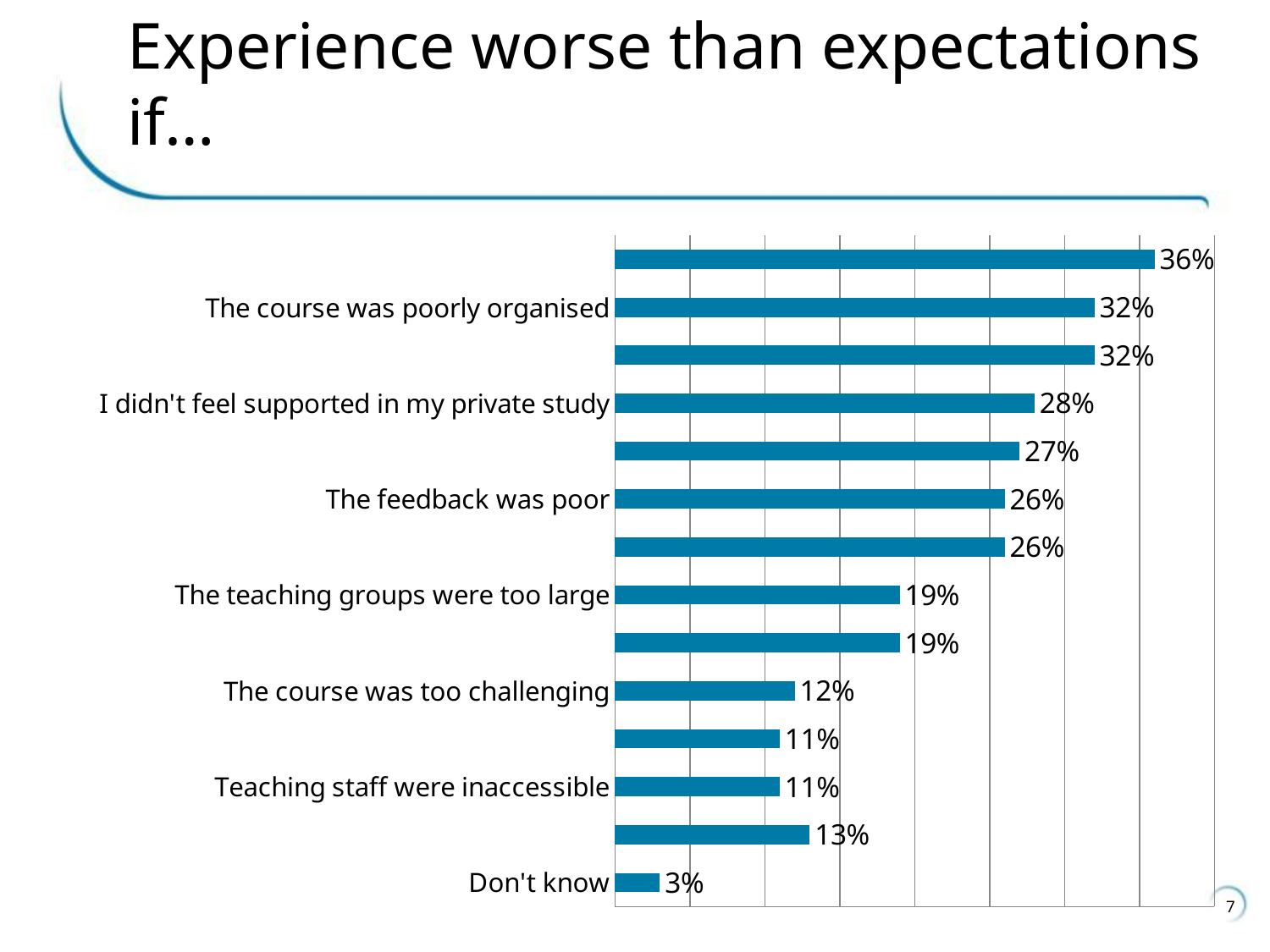
What is the value for "I didn't feel supported in my private study"? 28% What is the value for "The course was poorly organised"? 32% How many bars are plotted in the chart? 14 What is the value for "Teaching staff were inaccessible"? 11% Which category has the lowest value in the chart? Don't know What is the largest value shown on any bar in the chart? 36% What is the difference between the values for "The course was poorly organised" and "The feedback was poor"? 6% What is the value for "The teaching groups were too large"? 19% What is the value for "The feedback was poor"? 26% What kind of chart is shown on the slide? bar chart What is the value for "The course was too challenging"? 12% Which is larger, the value for "The teaching groups were too large" or the value for "The course was too challenging"? The teaching groups were too large